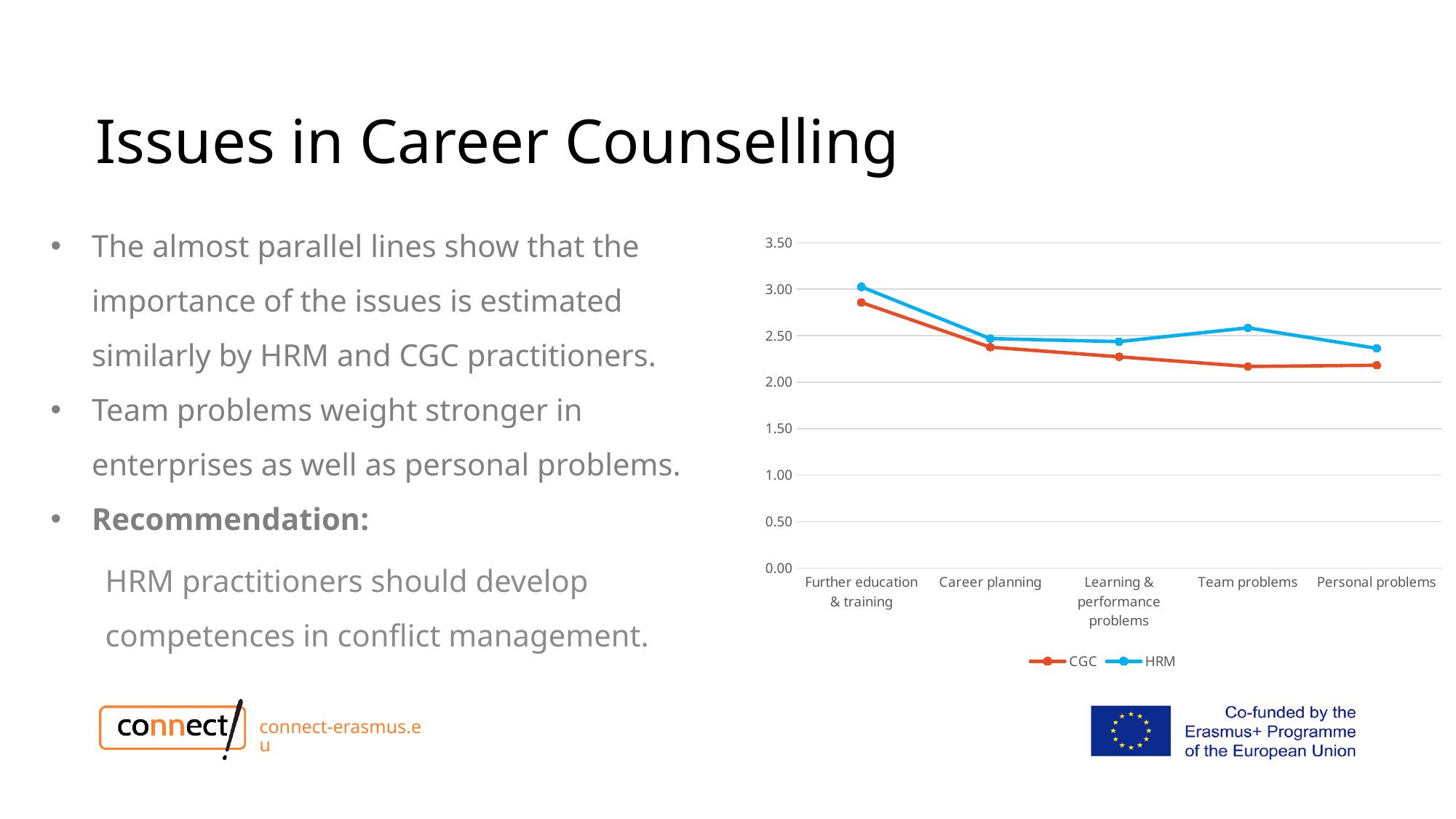
Is the CGC value for Further education & training greater or less than 2.50? greater How many series does the chart's legend list? 2 What kind of chart is shown on the slide? line chart Which category has the highest value for the HRM series? Further education & training Is the HRM value for Personal problems greater or less than 2.50? less Does the CGC line rise or fall from Further education & training to Team problems? fall Is the CGC value for Team problems greater or less than 2.50? less How many categories are shown on the x axis of the chart? 5 Which category has the highest value for the CGC series? Further education & training For Team problems, which series has the larger value, CGC or HRM? HRM Which colour is used for the HRM series in the chart? blue For Further education & training, which series has the larger value, CGC or HRM? HRM